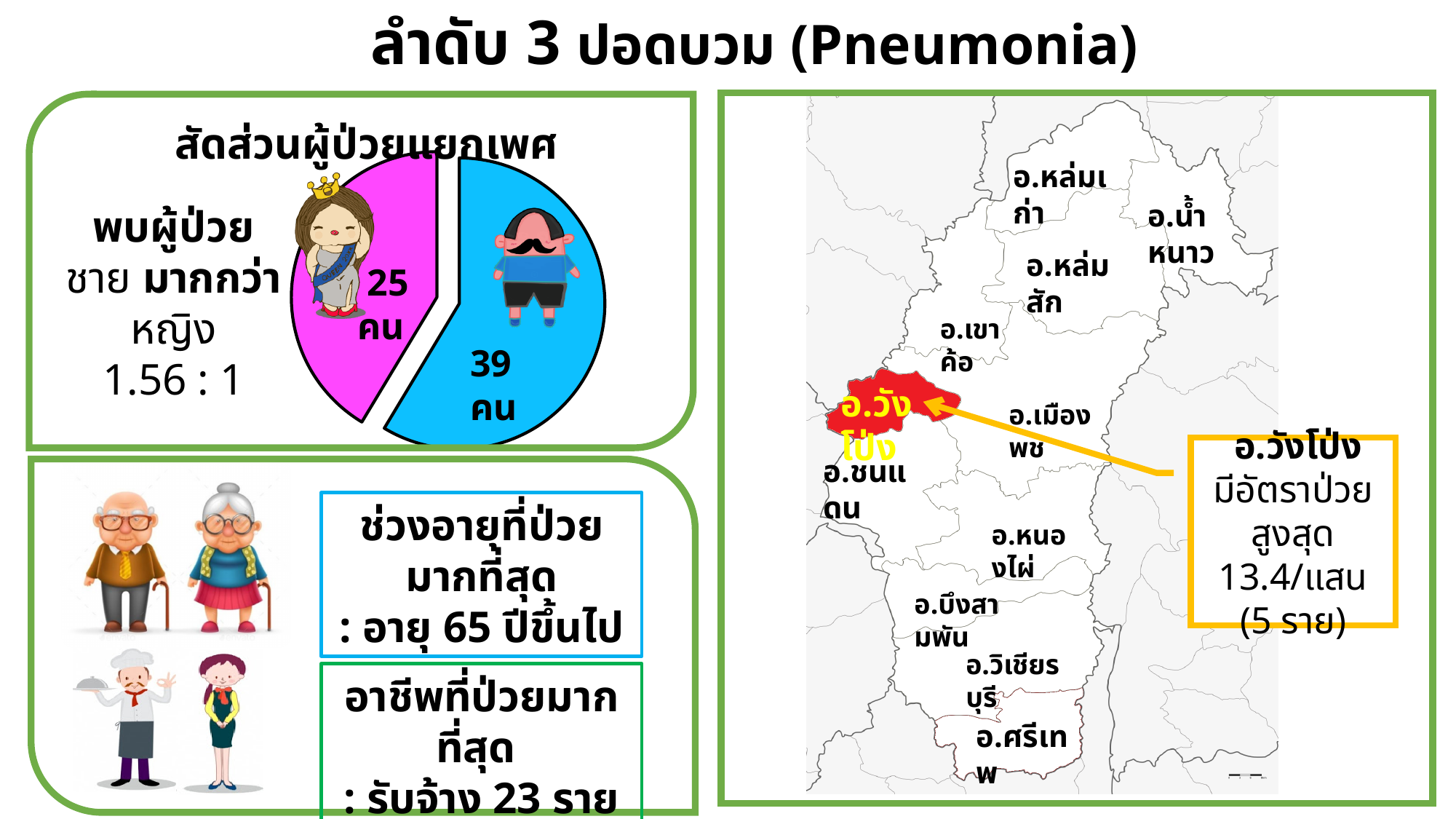
In the pie chart, how many patients are shown in the blue (male) slice? 39 คน What type of chart is shown in the top-left panel of the slide? pie chart In the pie chart, how many patients are shown in the pink (female) slice? 25 คน Which group has the highest number of patients in the pie chart? male (ชาย), 39 คน Is the number of male patients in the pie chart greater or less than 30? greater What is the difference between the male and female patient counts in the pie chart? 14 คน What is the total number of patients represented by the two slices of the pie chart? 64 คน What colour is the slice representing male patients in the pie chart? blue Which slice of the pie chart is larger, the pink (female) slice or the blue (male) slice? blue (male) How many slices does the pie chart have? 2 What is the title of the pie chart on the slide? สัดส่วนผู้ป่วยแยกเพศ Which group has the lowest number of patients in the pie chart? female (หญิง), 25 คน